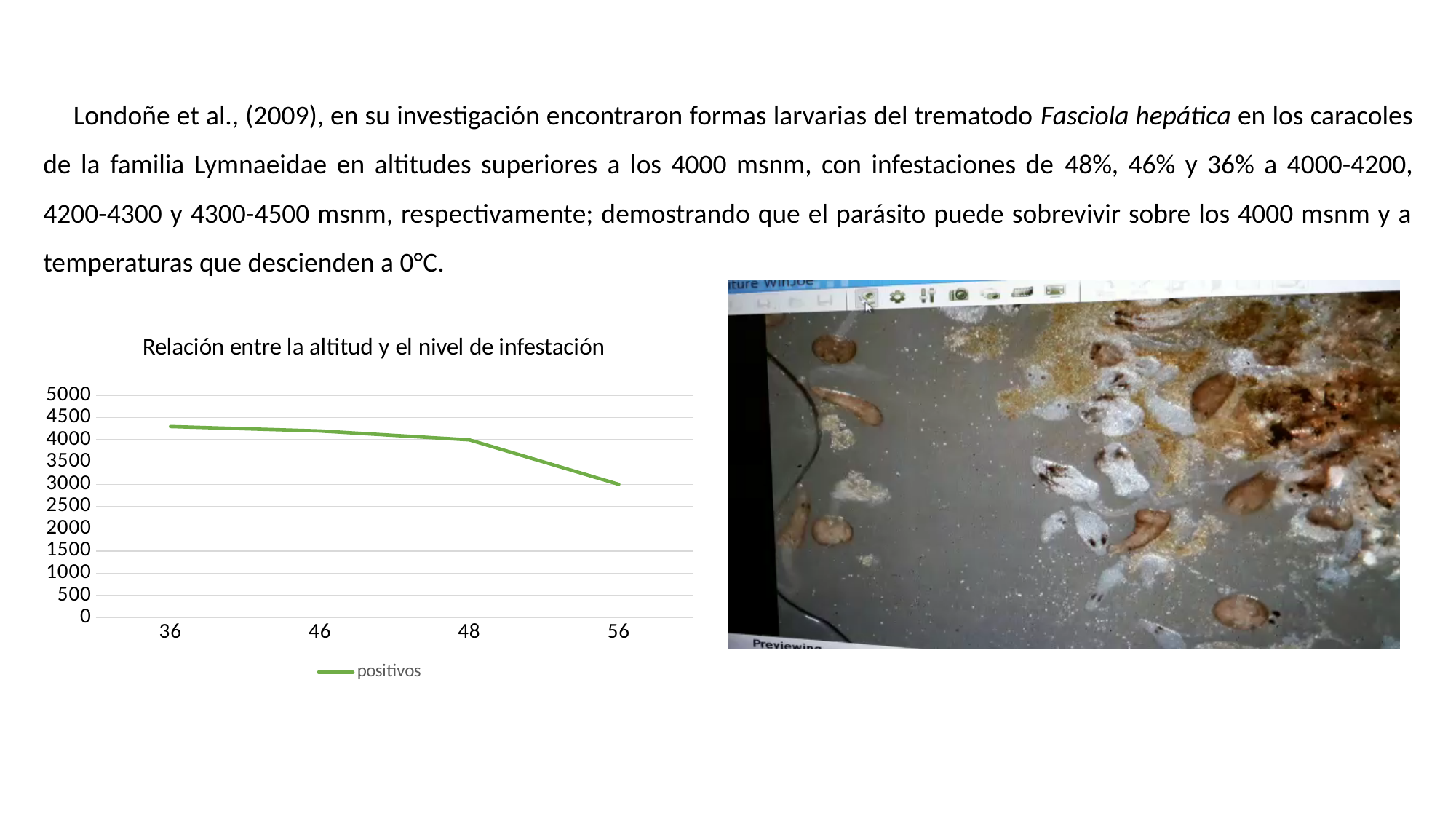
How many categories are plotted along the x axis? 4 Which category has the highest value for positivos? 36 What kind of chart is shown on the slide? line chart What is the name of the series shown in the legend? positivos What is the title of the chart? Relación entre la altitud y el nivel de infestación Is the value for positivos at 36 greater or less than 4000? greater Which is larger, the value for positivos at 36 or at 56? 36 Is the value for positivos at 46 greater or less than 4500? less How many series does the chart legend list? 1 Do the values rise or fall along the x axis from 36 to 56? fall Which category has the lowest value for positivos? 56 Is the value for positivos at 56 greater or less than 3500? less